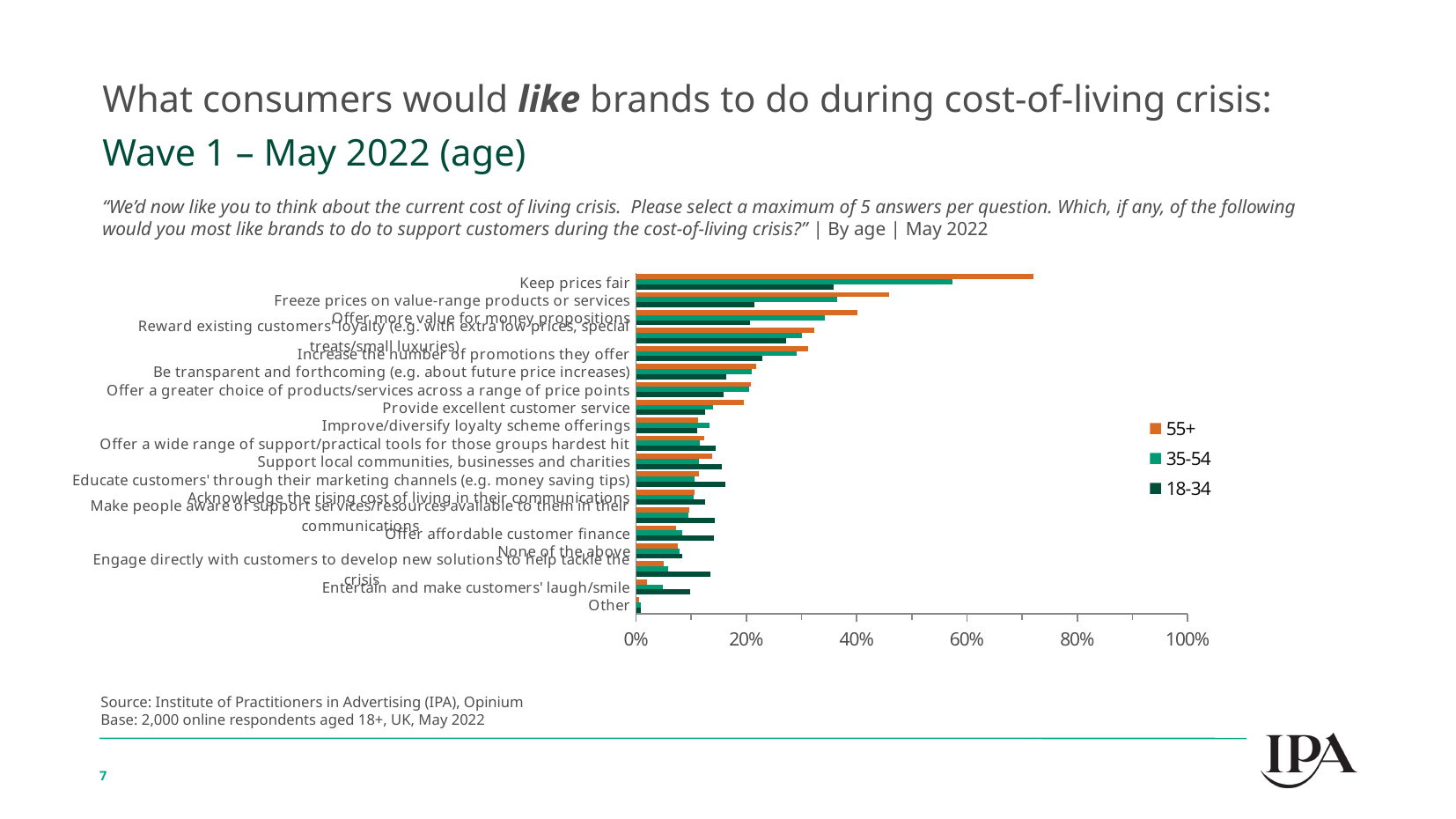
For 'Entertain and make customers' laugh/smile', which series has the larger value: 18-34 or 55+? 18-34 What kind of chart is shown on the slide? Bar chart Which series is shown in orange? 55+ How many categories are plotted on the chart? 19 Is the value for 'Keep prices fair' in the 55+ series greater or less than 60%? greater Which age groups are listed in the legend? 55+, 35-54, 18-34 Which category has the highest value for the 55+ series? Keep prices fair Is the value for 'Freeze prices on value-range products or services' in the 55+ series greater or less than 40%? greater How many series does the legend list? 3 Which category has the lowest value for the 55+ series? Other For 'Keep prices fair', which series has the larger value: 55+ or 18-34? 55+ Is the value for 'Keep prices fair' in the 18-34 series greater or less than 40%? less